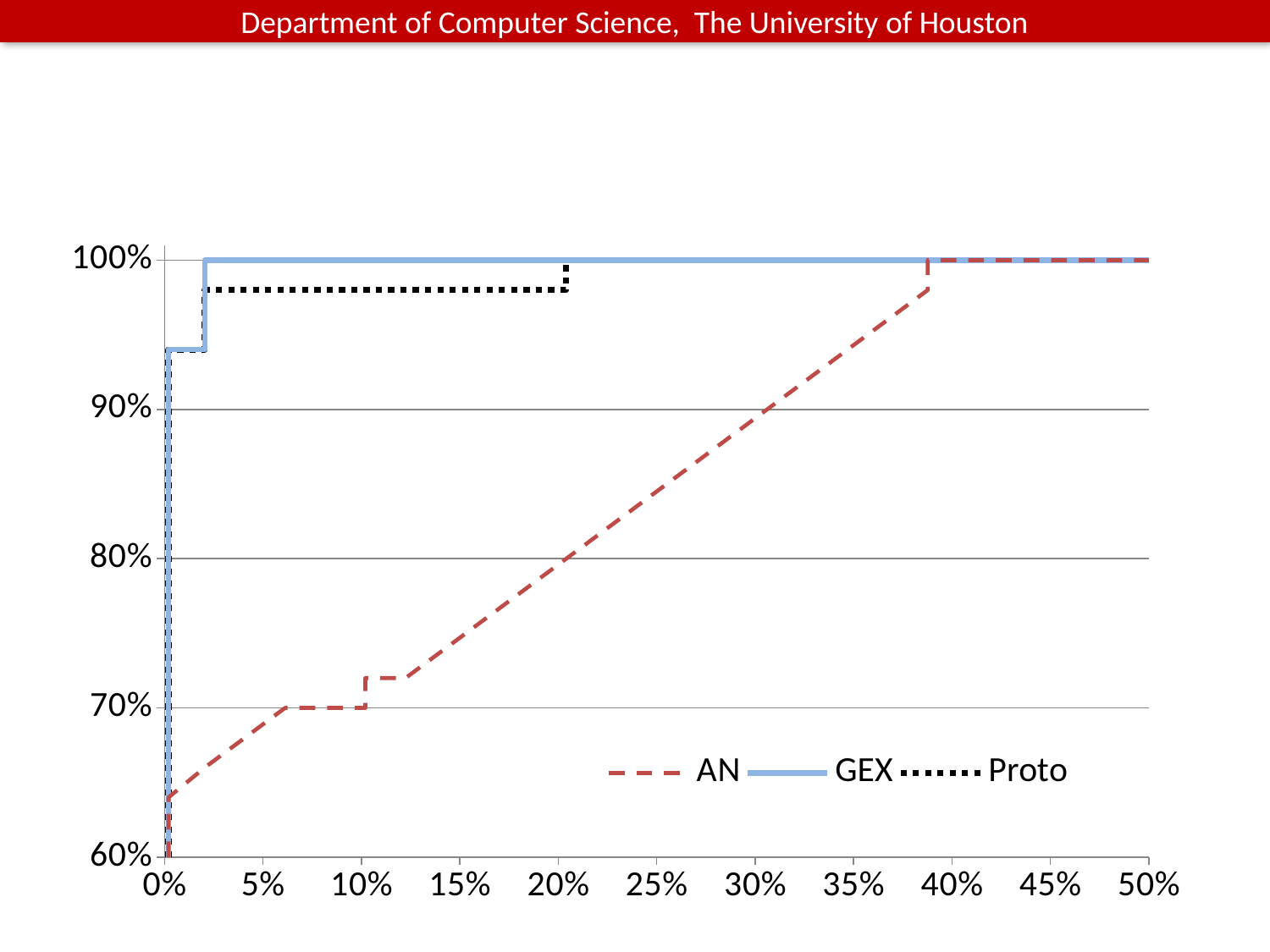
Which series has the lowest value at x = 15%? AN At x = 20%, which series has the larger value, GEX or AN? GEX At x = 10%, which series has the larger value, Proto or AN? Proto Which series is drawn as a solid blue line? GEX How many series does the legend list? 3 What are the names of the series listed in the legend? AN, GEX, Proto Does the AN series rise or fall as the x-axis value increases from 0% to 40%? rise Is the value of the AN series at x = 25% greater or less than 80%? greater Is the value of the GEX series at x = 10% greater or less than 90%? greater Is the value of the AN series at x = 5% greater or less than 70%? less What kind of chart is shown on the slide? line chart